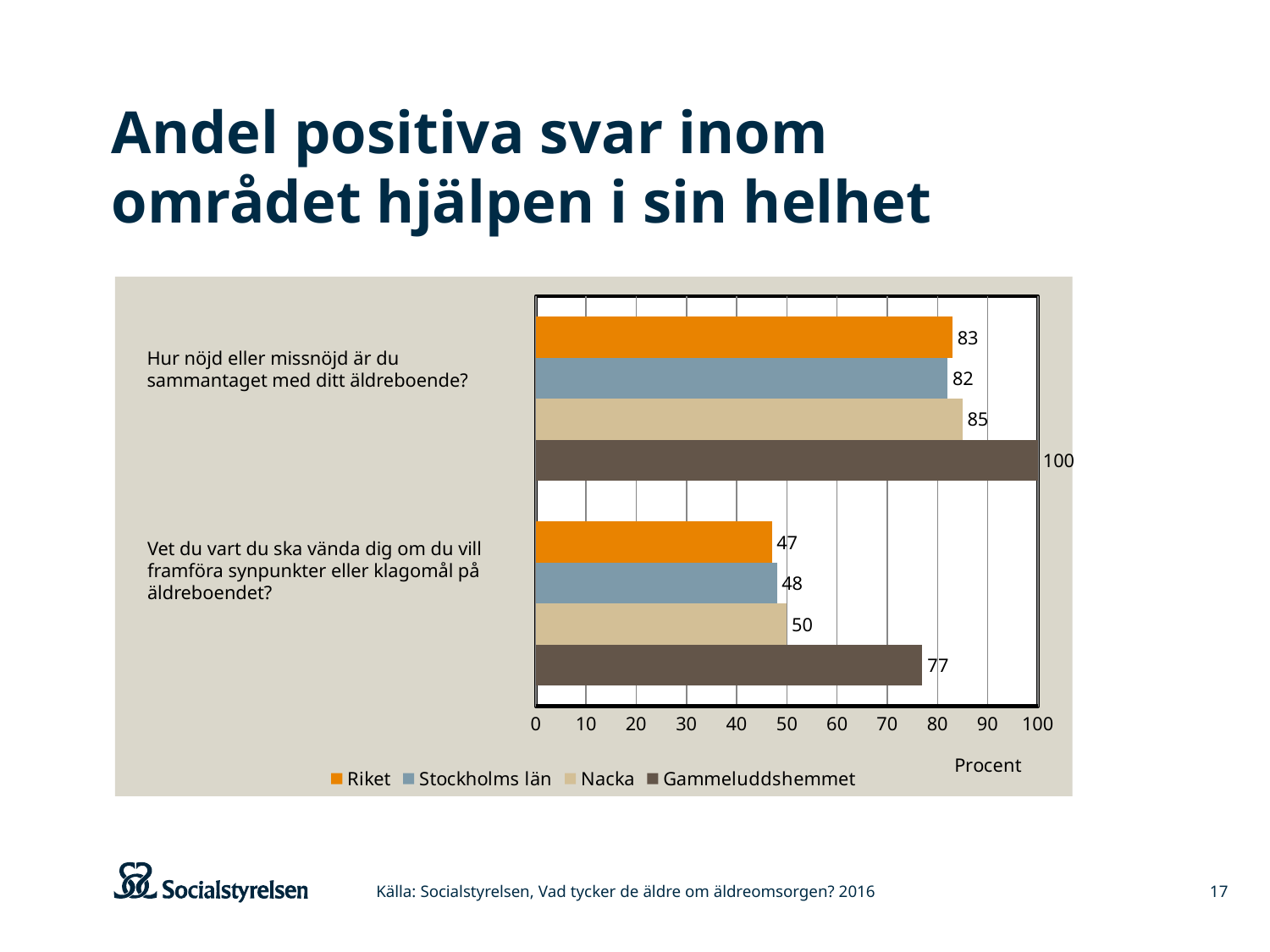
What is the value for Riket on the question "Vet du vart du ska vända dig om du vill framföra synpunkter eller klagomål på äldreboendet?"? 47 What is the value for Stockholms län on the question "Vet du vart du ska vända dig om du vill framföra synpunkter eller klagomål på äldreboendet?"? 48 What kind of chart is shown on the slide? Bar chart How many series does the legend list? 4 Which series has the lowest value on the question "Hur nöjd eller missnöjd är du sammantaget med ditt äldreboende?"? Stockholms län Which series has the highest value on the question "Vet du vart du ska vända dig om du vill framföra synpunkter eller klagomål på äldreboendet?"? Gammeluddshemmet What is the value for Nacka on the question "Hur nöjd eller missnöjd är du sammantaget med ditt äldreboende?"? 85 Is the value for Riket higher on "Hur nöjd eller missnöjd är du sammantaget med ditt äldreboende?" or on "Vet du vart du ska vända dig om du vill framföra synpunkter eller klagomål på äldreboendet?"? Hur nöjd eller missnöjd är du sammantaget med ditt äldreboende? What is the difference between Gammeluddshemmet and Nacka on the question "Vet du vart du ska vända dig om du vill framföra synpunkter eller klagomål på äldreboendet?"? 27 What is the value for Gammeluddshemmet on the question "Hur nöjd eller missnöjd är du sammantaget med ditt äldreboende?"? 100 What is the difference between Gammeluddshemmet's values on the two questions? 23 What unit is shown on the horizontal axis of the chart? Procent